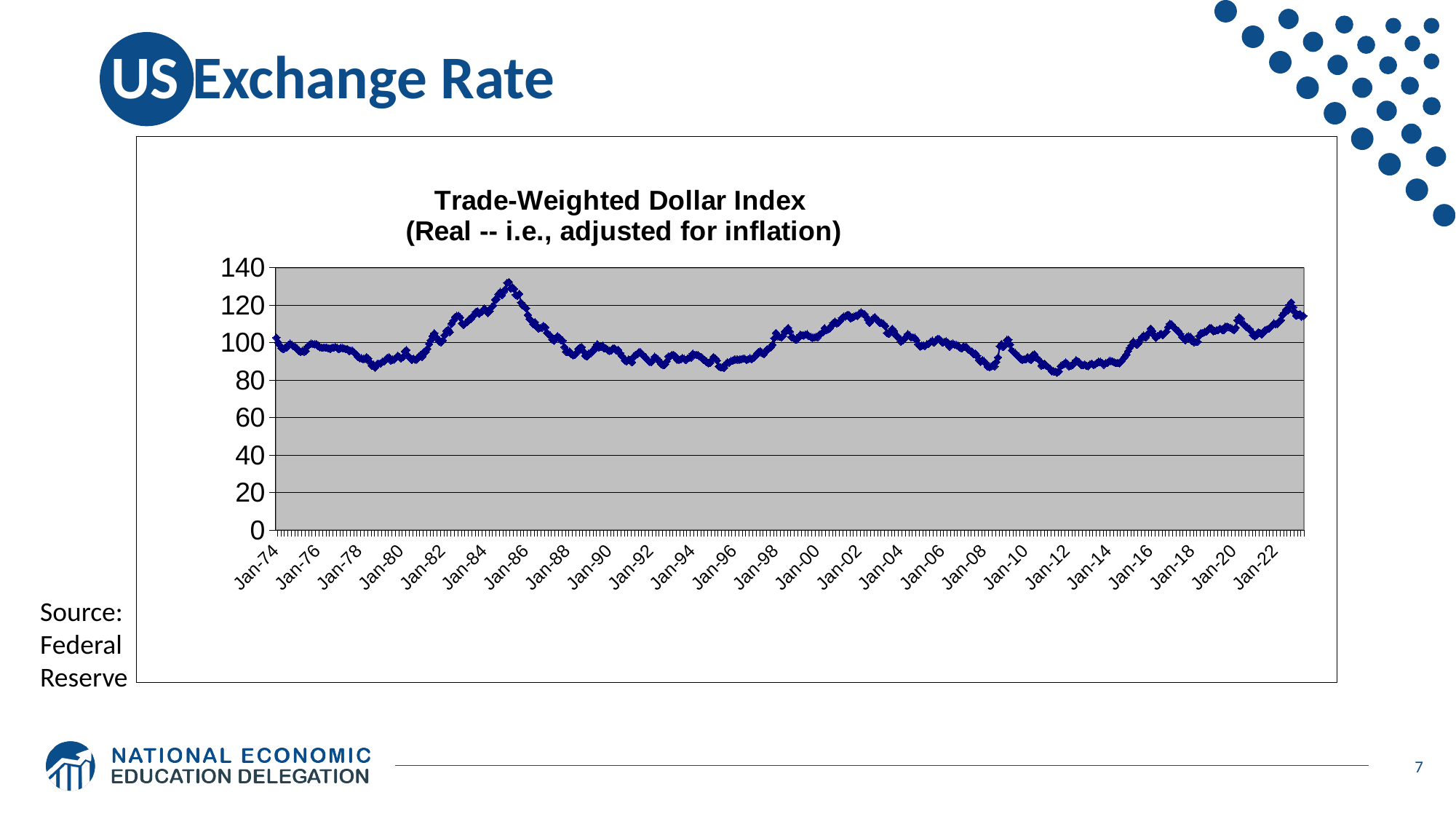
Does the index rise or fall between Jan-80 and Jan-85? rise Which is larger, the index value around Jan-86 or around Jan-02? Jan-86 What is the title of the chart? Trade-Weighted Dollar Index (Real -- i.e., adjusted for inflation) Is the value of the index around Jan-22 greater or less than 100? greater Around which year does the Trade-Weighted Dollar Index reach its highest value? 1985 Is the value of the index around Jan-12 greater or less than 100? less Is the peak value of the index around Jan-86 greater or less than 120? greater What is the highest value shown on the vertical axis? 140 What kind of chart is shown on the slide? line chart Does the index rise or fall between Jan-86 and Jan-88? fall